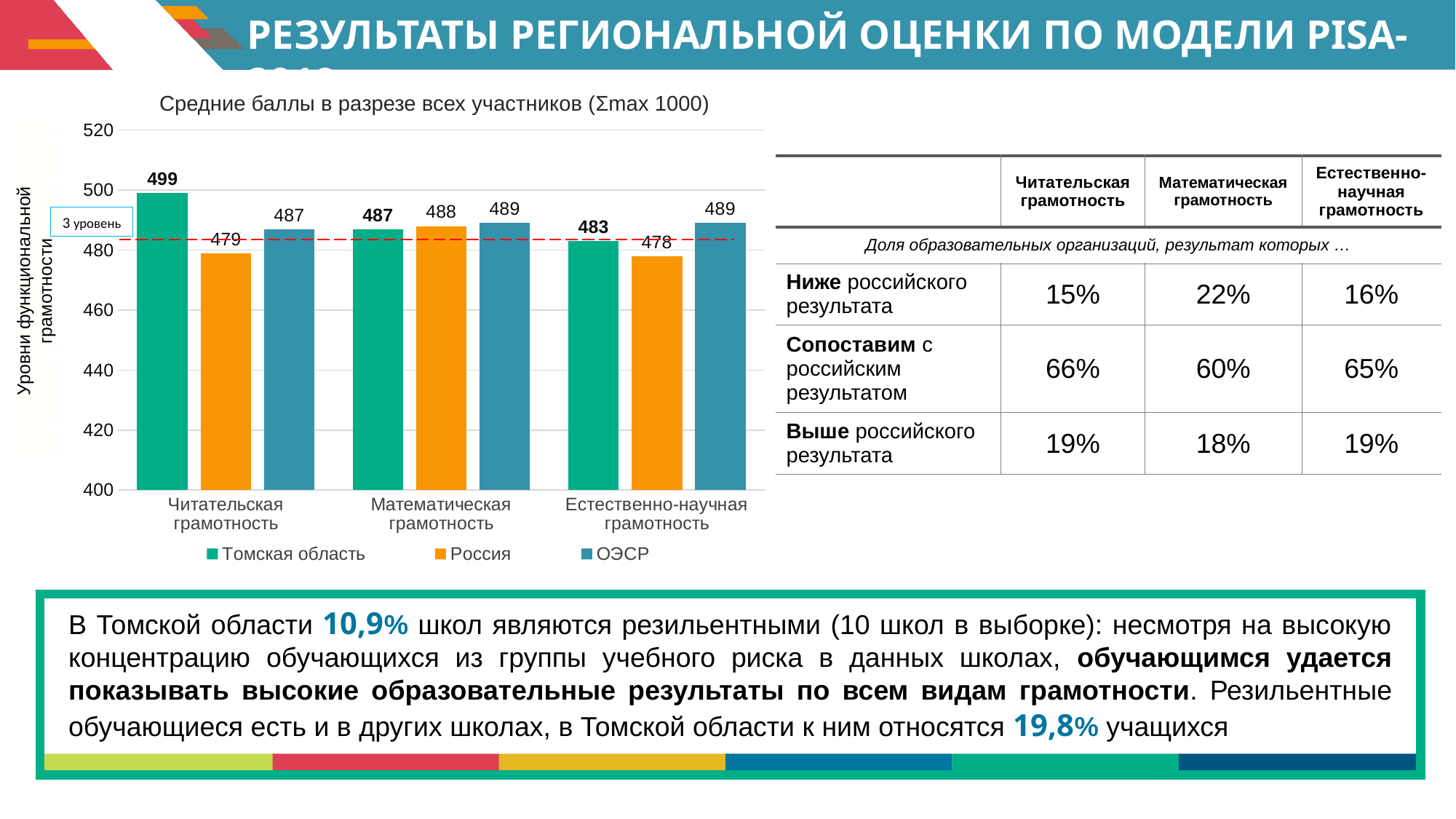
What is the value for ОЭСР in Математическая грамотность? 489 What is the value for Россия in Естественно-научная грамотность? 478 What is the value for Томская область in Читательская грамотность? 499 How many categories are shown on the x axis of the chart? 3 How many series does the chart legend list? 3 Which series has the highest value in Читательская грамотность? Томская область What is the difference between Томская область and Россия in Читательская грамотность? 20 What is the difference between ОЭСР and Томская область in Естественно-научная грамотность? 6 What is the title of the chart? Средние баллы в разрезе всех участников (Σmax 1000) Which series has the lowest value in Естественно-научная грамотность? Россия Which is larger: Томская область in Читательская грамотность or ОЭСР in Читательская грамотность? Томская область What kind of chart is shown on the slide? bar chart